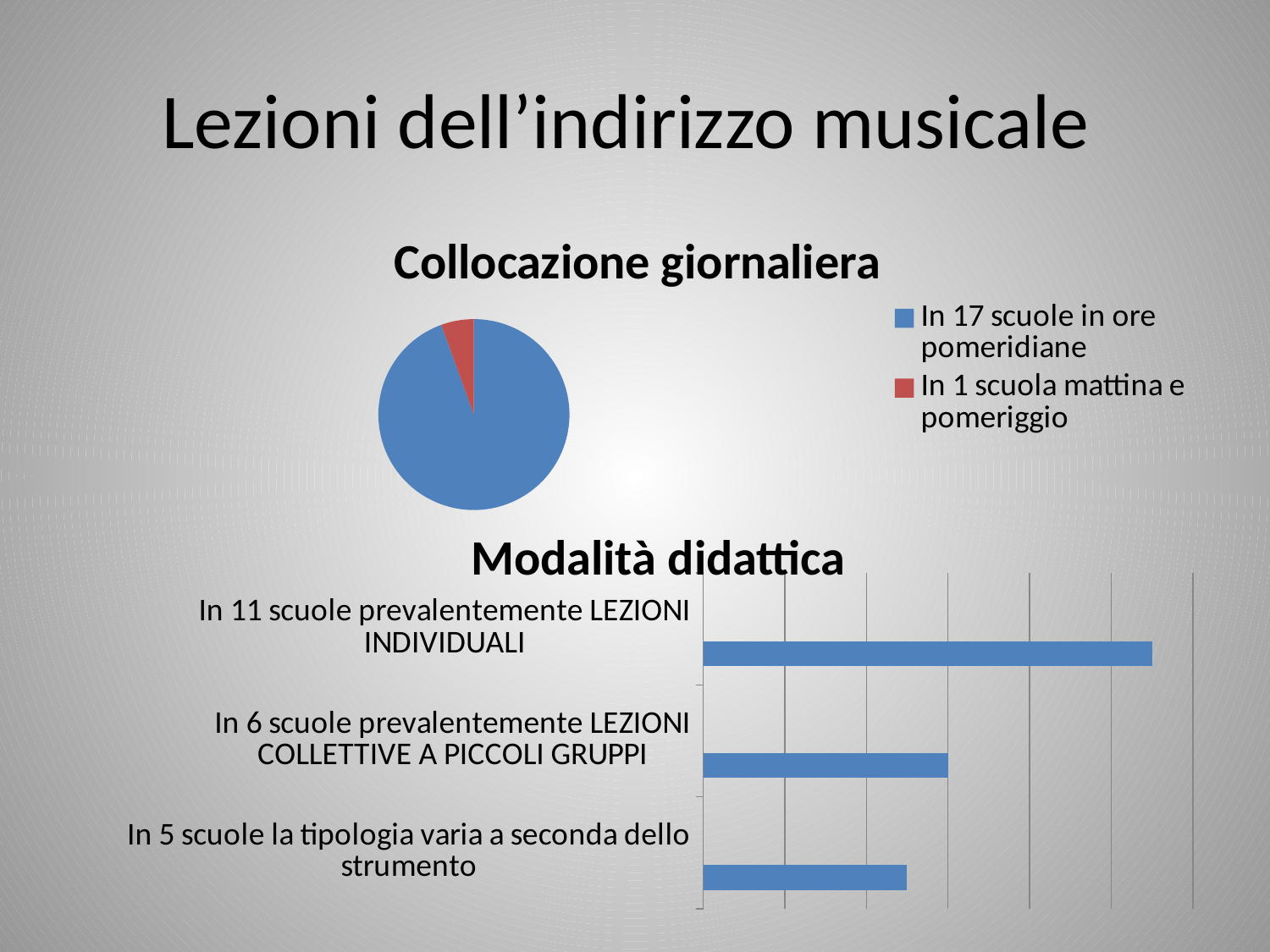
What kind of chart is the 'Modalità didattica' chart? bar chart In the 'Collocazione giornaliera' pie chart, how many entries does the legend list? 2 In the 'Modalità didattica' bar chart, which bar is longer: the one for LEZIONI COLLETTIVE A PICCOLI GRUPPI or the one for 'la tipologia varia a seconda dello strumento'? LEZIONI COLLETTIVE A PICCOLI GRUPPI In the 'Modalità didattica' bar chart, which category has the shortest bar? In 5 scuole la tipologia varia a seconda dello strumento In the 'Modalità didattica' bar chart, what is the difference between the number of schools with mainly individual lessons and the number with mainly collective lessons in small groups? 5 In the 'Collocazione giornaliera' pie chart, what colour is the slice for 'In 1 scuola mattina e pomeriggio'? red In the 'Modalità didattica' bar chart, which category has the longest bar? In 11 scuole prevalentemente LEZIONI INDIVIDUALI In the 'Collocazione giornaliera' pie chart, how many schools hold lessons in the afternoon hours ('in ore pomeridiane')? 17 In the 'Collocazione giornaliera' pie chart, which slice is larger: 'In 17 scuole in ore pomeridiane' or 'In 1 scuola mattina e pomeriggio'? In 17 scuole in ore pomeridiane How many categories does the 'Modalità didattica' bar chart show? 3 What kind of chart is the 'Collocazione giornaliera' chart? pie chart In the 'Modalità didattica' bar chart, how many schools mainly use collective lessons in small groups (LEZIONI COLLETTIVE A PICCOLI GRUPPI)? 6